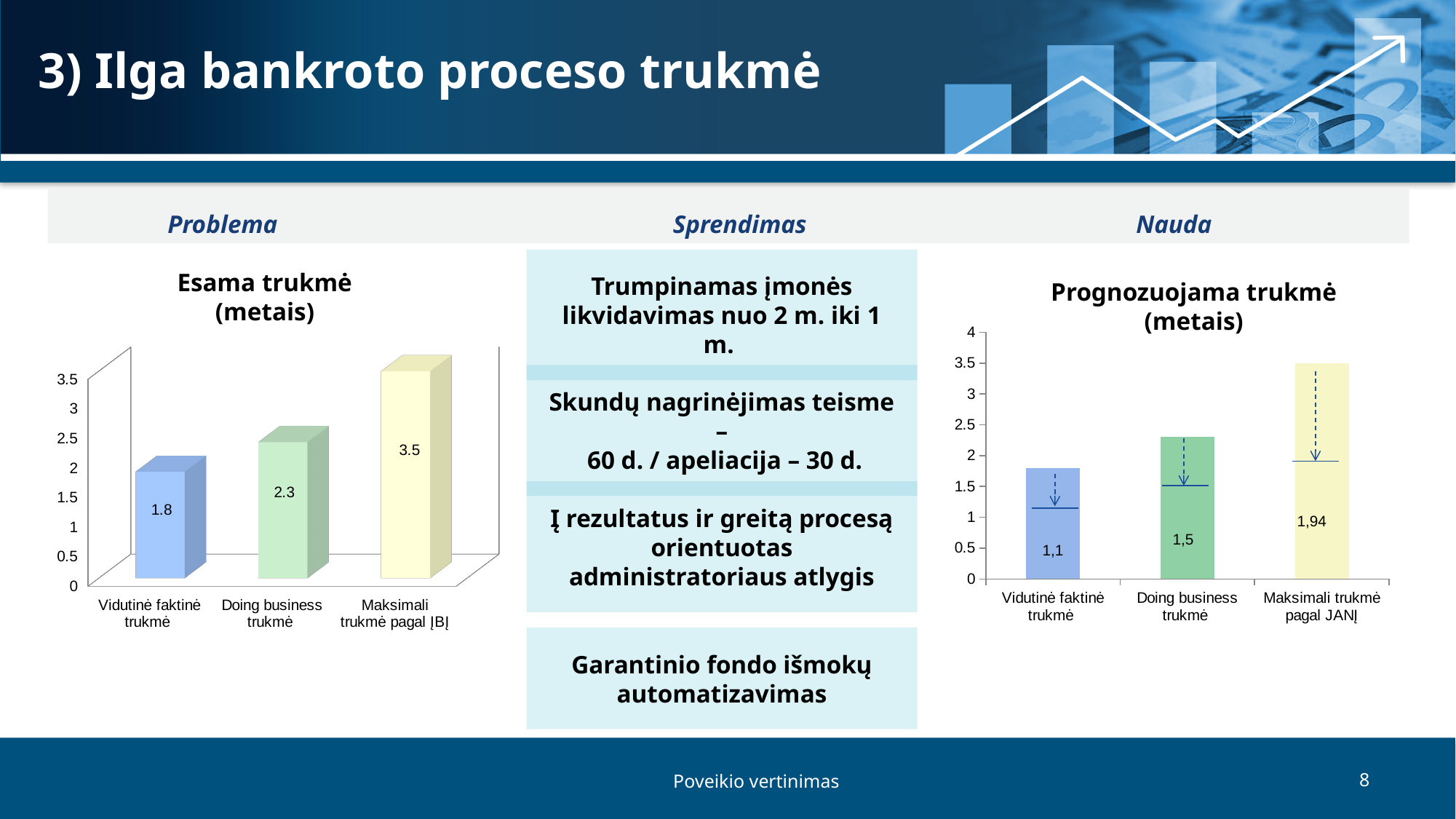
In the chart titled "Prognozuojama trukmė (metais)", what is the data label for Maksimali trukmė pagal JANĮ? 1,94 What kind of chart is the chart titled "Esama trukmė (metais)"? Bar chart In the chart titled "Esama trukmė (metais)", do the values rise or fall from left to right along the x axis? Rise In the chart titled "Esama trukmė (metais)", what is the value for Maksimali trukmė pagal ĮBĮ? 3.5 In the chart titled "Prognozuojama trukmė (metais)", what is the data label for Doing business trukmė? 1,5 In the chart titled "Esama trukmė (metais)", what is the difference between Maksimali trukmė pagal ĮBĮ and Vidutinė faktinė trukmė? 1.7 In the chart titled "Esama trukmė (metais)", which category has the highest value? Maksimali trukmė pagal ĮBĮ How many categories are shown in the chart titled "Prognozuojama trukmė (metais)"? 3 In the chart titled "Esama trukmė (metais)", what is the value for Doing business trukmė? 2.3 In the chart titled "Esama trukmė (metais)", which category has the lowest value? Vidutinė faktinė trukmė In the chart titled "Esama trukmė (metais)", what is the value for Vidutinė faktinė trukmė? 1.8 In the chart titled "Prognozuojama trukmė (metais)", what is the data label for Vidutinė faktinė trukmė? 1,1